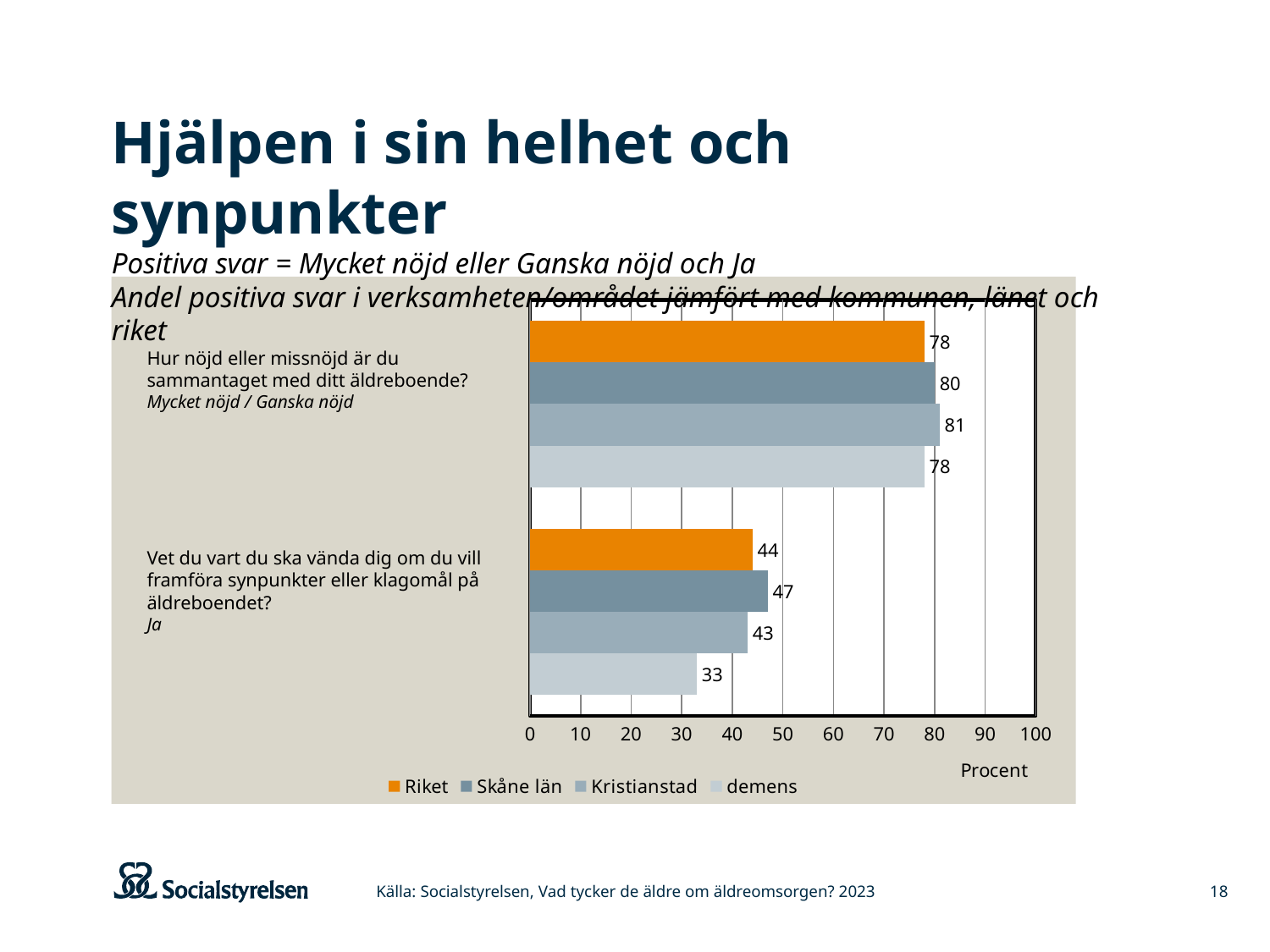
What is the difference between the Riket value for the overall satisfaction question (78) and the Riket value for the complaints question (44)? 34 What is the value for Kristianstad on the question "Hur nöjd eller missnöjd är du sammantaget med ditt äldreboende?"? 81 What is the value for Riket on the question "Hur nöjd eller missnöjd är du sammantaget med ditt äldreboende?"? 78 What unit label is shown on the x axis of the chart? Procent What kind of chart is shown on the slide? bar chart Which is larger on the question "Hur nöjd eller missnöjd är du sammantaget med ditt äldreboende?": the value for Skåne län or the value for Riket? Skåne län Which series has the highest value on the question "Vet du vart du ska vända dig om du vill framföra synpunkter eller klagomål på äldreboendet?"? Skåne län What is the value for Skåne län on the question "Vet du vart du ska vända dig om du vill framföra synpunkter eller klagomål på äldreboendet?"? 47 How many series does the chart legend list? 4 Which series has the lowest value on the question "Vet du vart du ska vända dig om du vill framföra synpunkter eller klagomål på äldreboendet?"? demens What is the value for demens on the question "Vet du vart du ska vända dig om du vill framföra synpunkter eller klagomål på äldreboendet?"? 33 What is the difference between the Kristianstad value and the demens value on the question "Vet du vart du ska vända dig om du vill framföra synpunkter eller klagomål på äldreboendet?"? 10